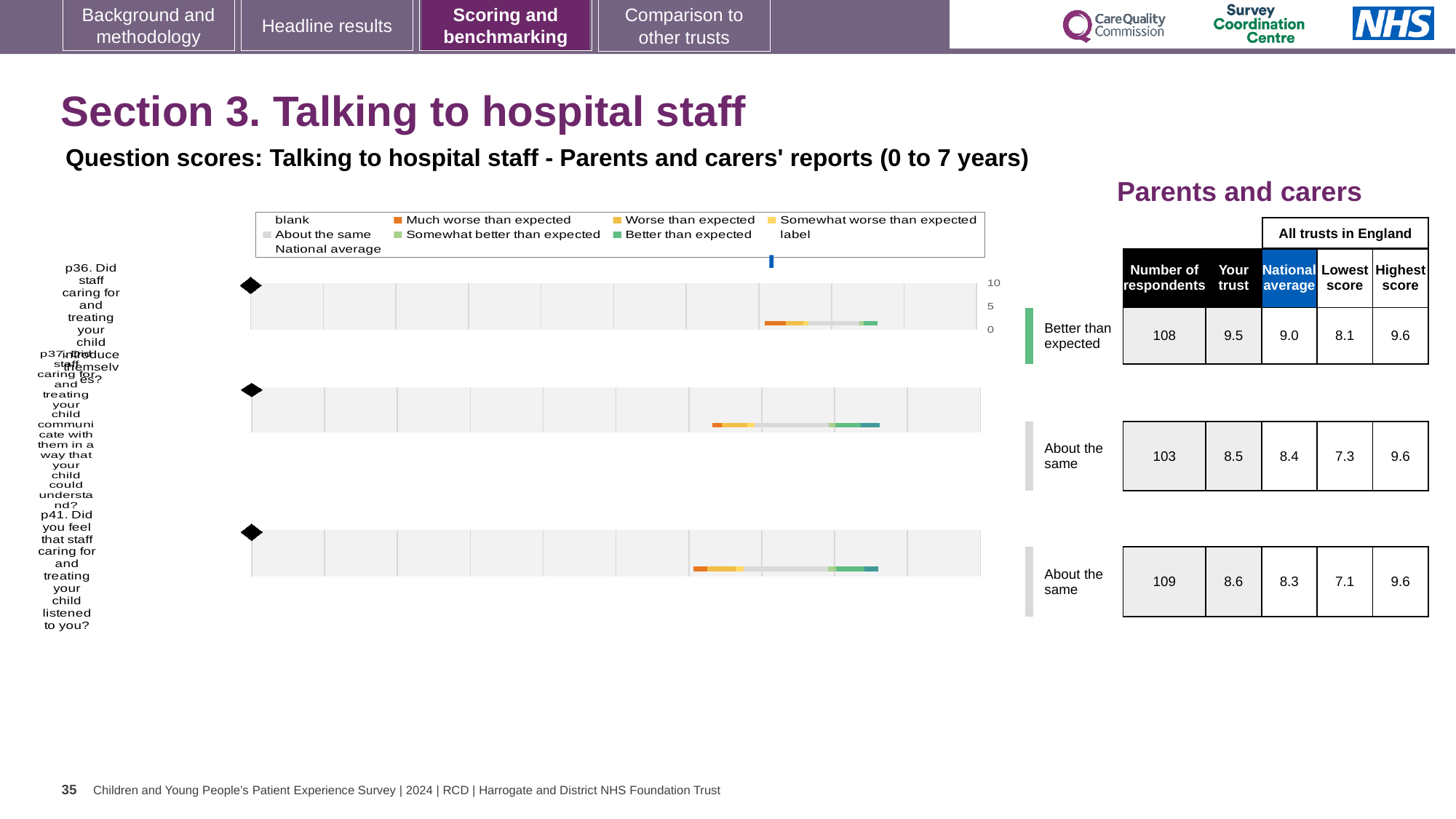
In the table beside the chart, what is the National average score for p41 (Did you feel that staff listened to you)? 8.3 Is the 'Your trust' score higher for p41 or for p37? p41 Which of the three questions has the highest 'Your trust' score in the table beside the chart? p36 In the table beside the chart, what is the 'Your trust' score for p36 (Did staff caring for and treating your child introduce themselves)? 9.5 What is the highest tick value shown on the chart's score axis? 10 In the table beside the chart, how many respondents answered p37? 103 How many survey questions (p36, p37, p41) are plotted in the chart? 3 What kind of chart is used to show the question scores for Talking to hospital staff? bar chart What is the Lowest score across all trusts in England for p37? 7.3 Which of the three questions has the lowest 'Your trust' score in the table beside the chart? p37 By how much does the 'Your trust' score for p36 exceed the National average for p36? 0.5 Which question in the chart is rated 'Better than expected'? p36